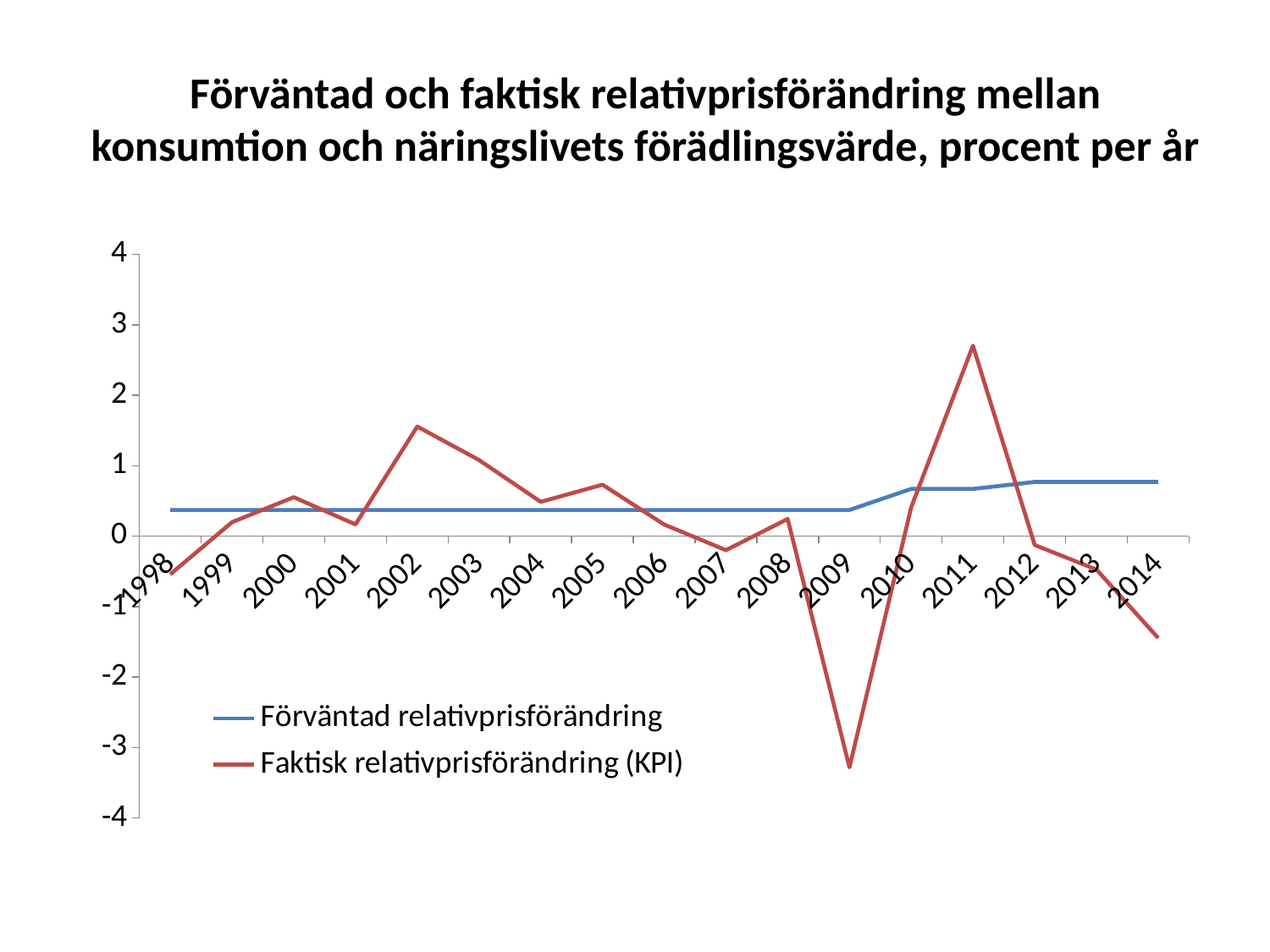
Is the value for Faktisk relativprisförändring (KPI) in 2009 greater or less than -3? less What kind of chart is shown on the slide? line chart In which year does the Faktisk relativprisförändring (KPI) series reach its highest value? 2011 How many series does the legend list? 2 Is the value for Faktisk relativprisförändring (KPI) in 2014 greater or less than -1? less Is the value for Faktisk relativprisförändring (KPI) in 2002 greater or less than 1? greater Does the Förväntad relativprisförändring series rise or fall between 2009 and 2012? rise For Faktisk relativprisförändring (KPI), which year has the larger value, 2002 or 2011? 2011 How many years are shown on the x axis? 17 In which year does the Faktisk relativprisförändring (KPI) series reach its lowest value? 2009 In 2009, which series has the higher value, Förväntad relativprisförändring or Faktisk relativprisförändring (KPI)? Förväntad relativprisförändring